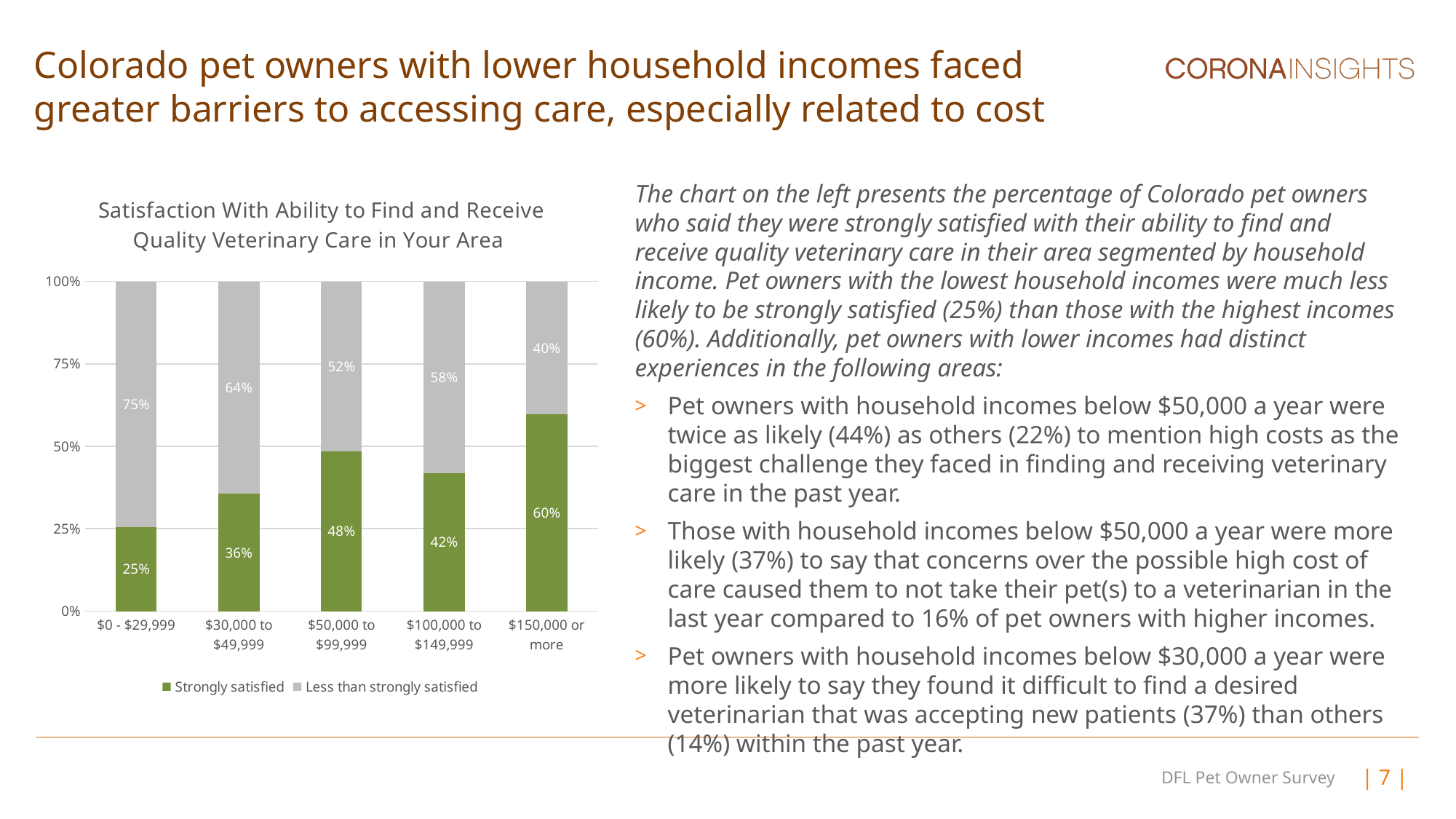
What is the difference in 'Strongly satisfied' percentage between the $150,000 or more group and the $0 - $29,999 group? 35% What colour represents the 'Strongly satisfied' series? Green How many income categories are shown on the x axis? 5 How many series does the legend list? 2 Which has a larger 'Strongly satisfied' share: the $50,000 to $99,999 group or the $100,000 to $149,999 group? $50,000 to $99,999 What is the 'Strongly satisfied' value for the $50,000 to $99,999 income group? 48% What is the total of the stacked bar for the $30,000 to $49,999 group? 100% What kind of chart is shown on the slide? Stacked bar chart What percentage of pet owners with household incomes of $0 - $29,999 were strongly satisfied? 25% Which income group has the highest 'Strongly satisfied' percentage? $150,000 or more What percentage of pet owners with household incomes of $150,000 or more were less than strongly satisfied? 40% Which income group has the lowest 'Strongly satisfied' percentage? $0 - $29,999